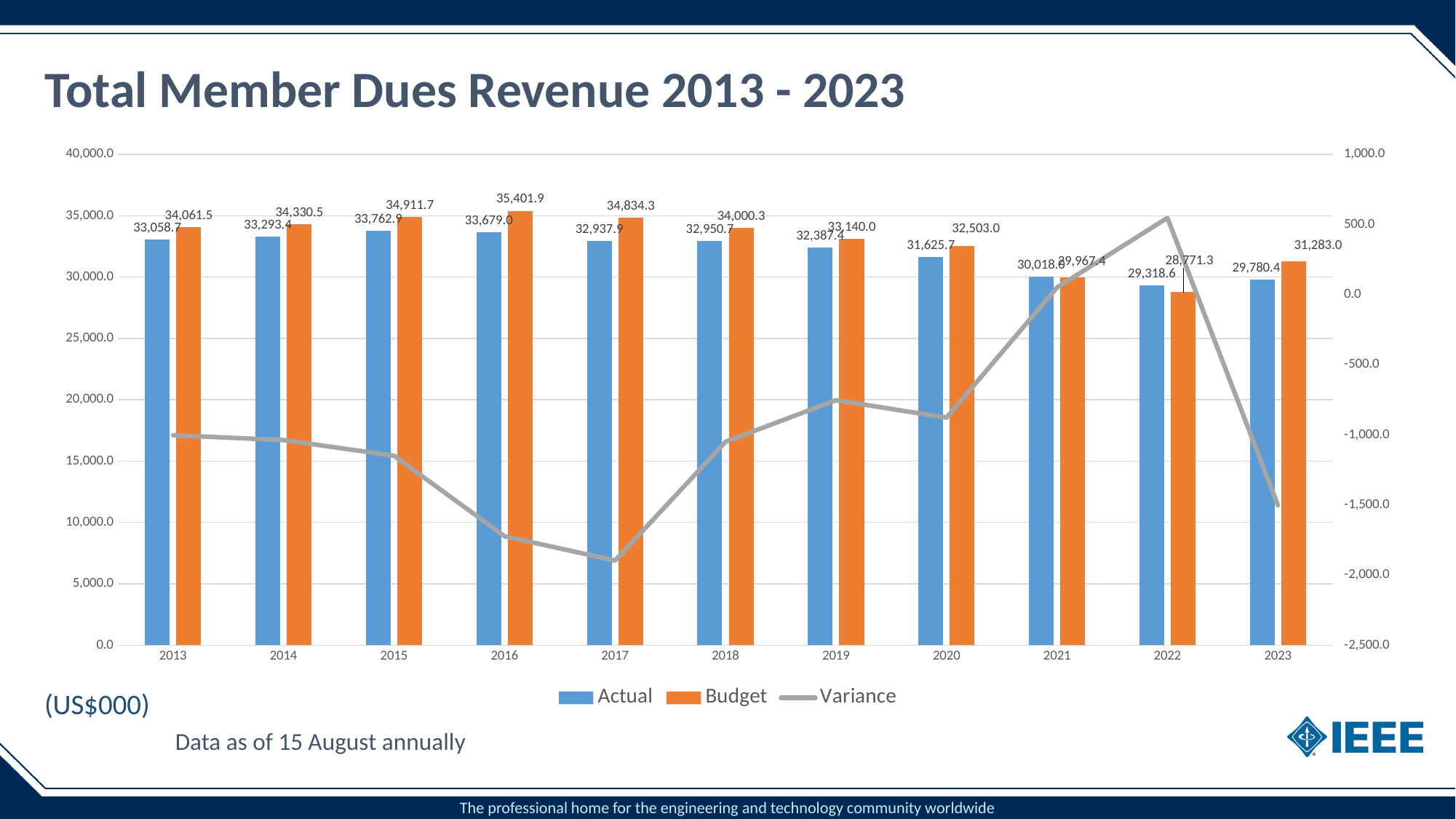
In 2022, which is larger, the Actual value or the Budget value? Actual How many years are shown on the x axis? 11 Is the Variance value for 2017 greater or less than -1,500.0 on the right-hand axis? less How many series does the legend list? 3 What is the Budget value for 2023? 31,283.0 What is the Actual value for 2016? 33,679.0 Does the Budget value rise or fall from 2016 to 2022? Falls By how much does the Actual value exceed the Budget value in 2022? 547.3 In which year is the Actual value lowest? 2022 In which year is the Budget value highest? 2016 By how much does the Budget value exceed the Actual value in 2013? 1,002.8 What kind of chart is shown on the slide? Combination bar and line chart